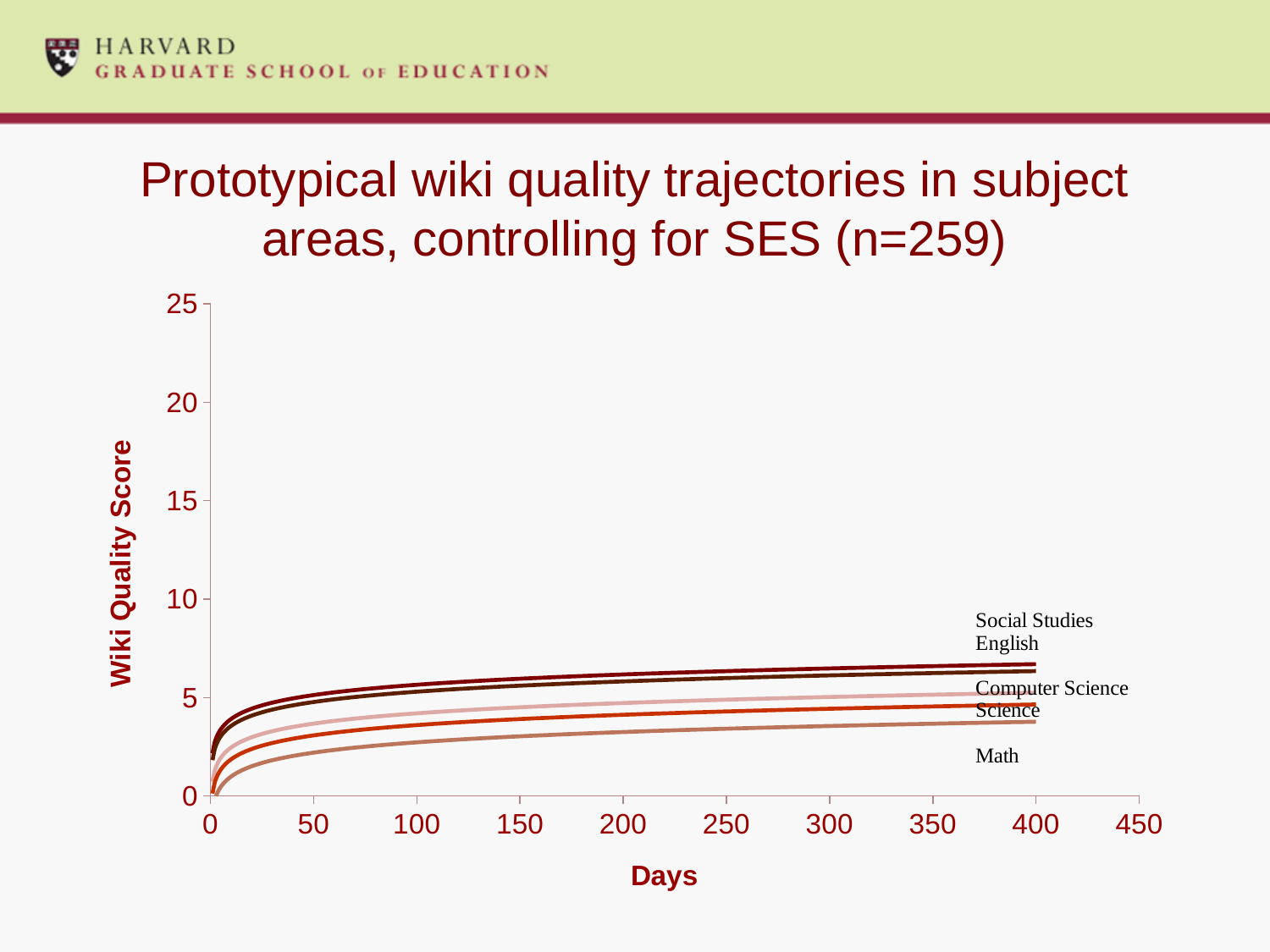
Is the wiki quality score for Math at 400 days greater or less than 5? less Do the wiki quality scores rise or fall as the number of days increases? rise What kind of chart is shown on the slide? line chart Which subject area has the lowest wiki quality trajectory? Math Which has the higher wiki quality score at 400 days, English or Science? English Which has the higher wiki quality score at 400 days, Social Studies or Math? Social Studies How many subject-area lines are plotted on the chart? 5 Is the wiki quality score for Computer Science at 400 days greater or less than 10? less Is the wiki quality score for Social Studies at 400 days greater or less than 5? greater What is the label of the horizontal axis? Days What is the label of the vertical axis? Wiki Quality Score